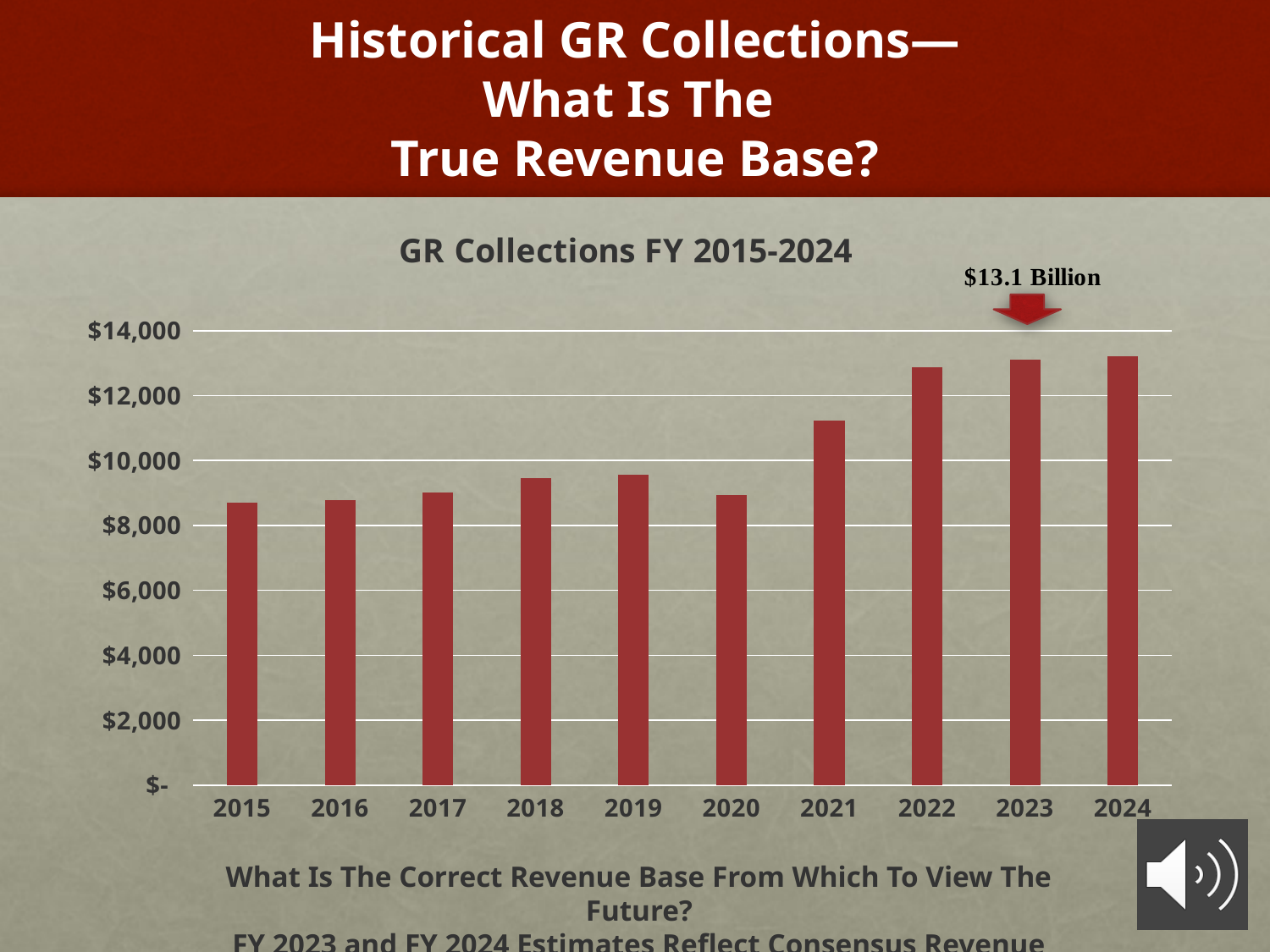
Is the value for 2015 greater or less than $10,000? less Do the values rise or fall from 2020 to 2024? rise Is the value for 2022 greater or less than $12,000? greater Is the value for 2023 greater or less than $14,000? less Which year has the larger value, 2015 or 2019? 2019 What value does the annotation give for GR collections in 2023? $13.1 Billion What is the title of the chart? GR Collections FY 2015-2024 How many fiscal years are plotted in the chart? 10 Which year has the larger value, 2020 or 2021? 2021 What type of chart is shown on the slide? bar chart